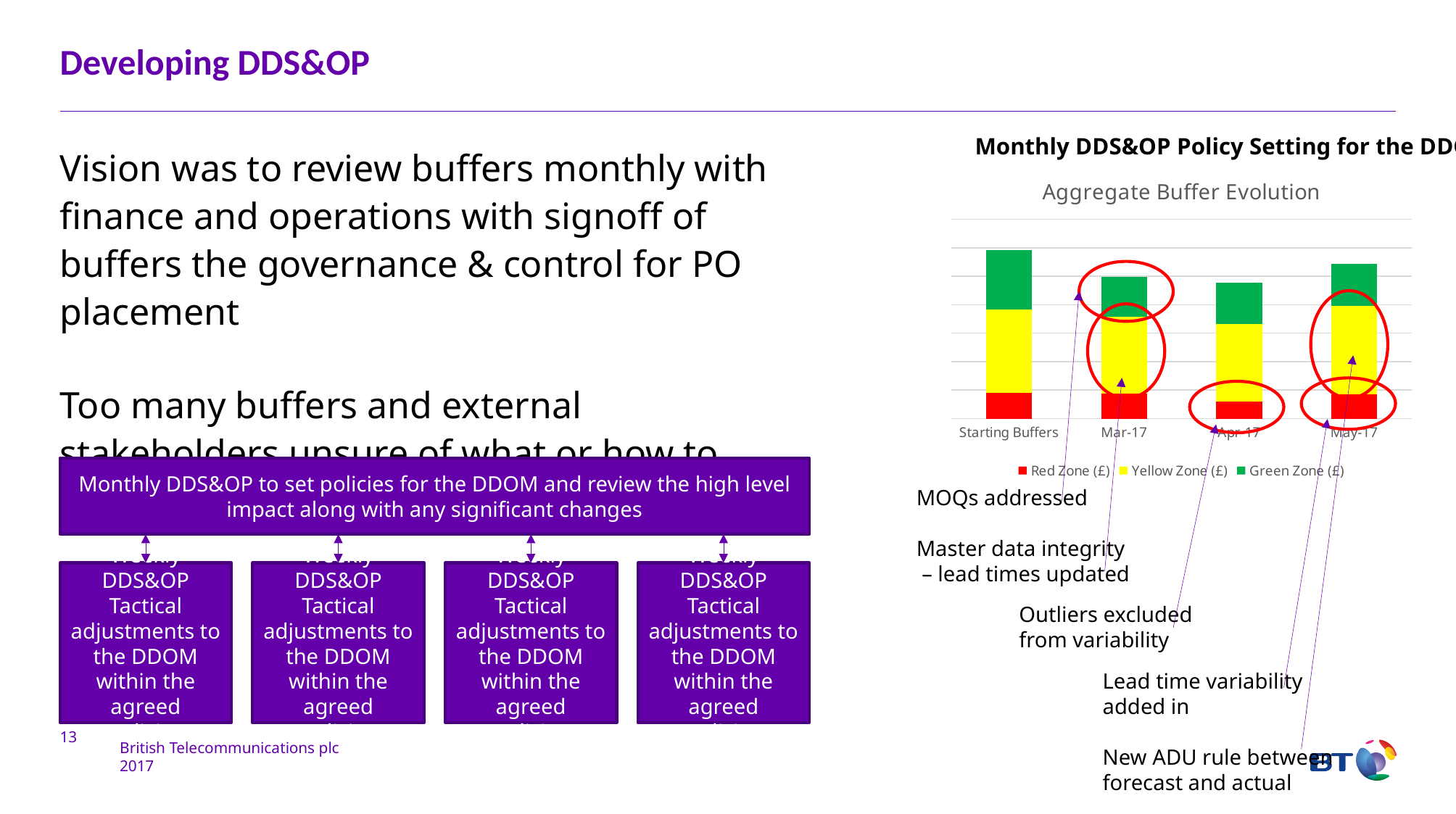
What type of chart is the Aggregate Buffer Evolution chart? stacked bar chart Which series in the Aggregate Buffer Evolution chart is shown in green? Green Zone (£) Which category in the Aggregate Buffer Evolution chart has the tallest total stacked bar? Starting Buffers What is the title of the chart on the slide? Aggregate Buffer Evolution What is the label of the first category on the x axis of the Aggregate Buffer Evolution chart? Starting Buffers In the Aggregate Buffer Evolution chart, is the total bar for Starting Buffers or Apr-17 taller? Starting Buffers How many series does the legend of the Aggregate Buffer Evolution chart list? 3 Which category in the Aggregate Buffer Evolution chart has the largest Green Zone (£) segment? Starting Buffers In the Aggregate Buffer Evolution chart, is the Red Zone (£) segment larger for Starting Buffers or Apr-17? Starting Buffers How many categories are shown on the x axis of the Aggregate Buffer Evolution chart? 4 Which category in the Aggregate Buffer Evolution chart has the smallest Red Zone (£) segment? Apr-17